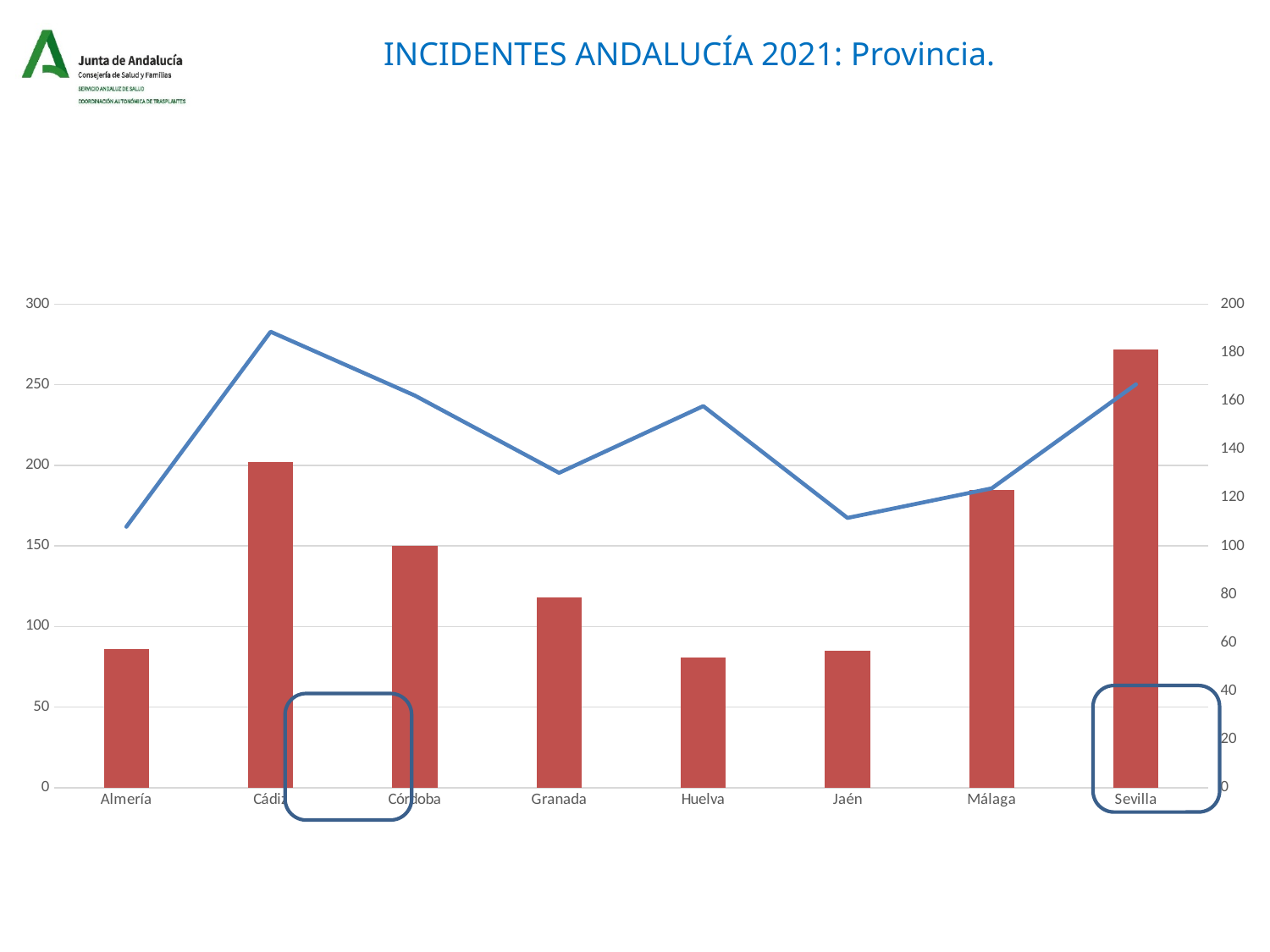
What kind of chart is shown on the slide? A combined bar and line chart Which province has the highest point on the blue line? Cádiz Which has the higher point on the line, Huelva or Jaén? Huelva Is the bar for Granada greater or less than 100 on the left axis? greater How many provinces are shown along the x axis? 8 Is the bar for Almería greater or less than 100 on the left axis? less Is the bar for Málaga greater or less than 200 on the left axis? less What is the title of the slide? INCIDENTES ANDALUCÍA 2021: Provincia. Which province has the tallest bar? Sevilla Which has the taller bar, Cádiz or Córdoba? Cádiz